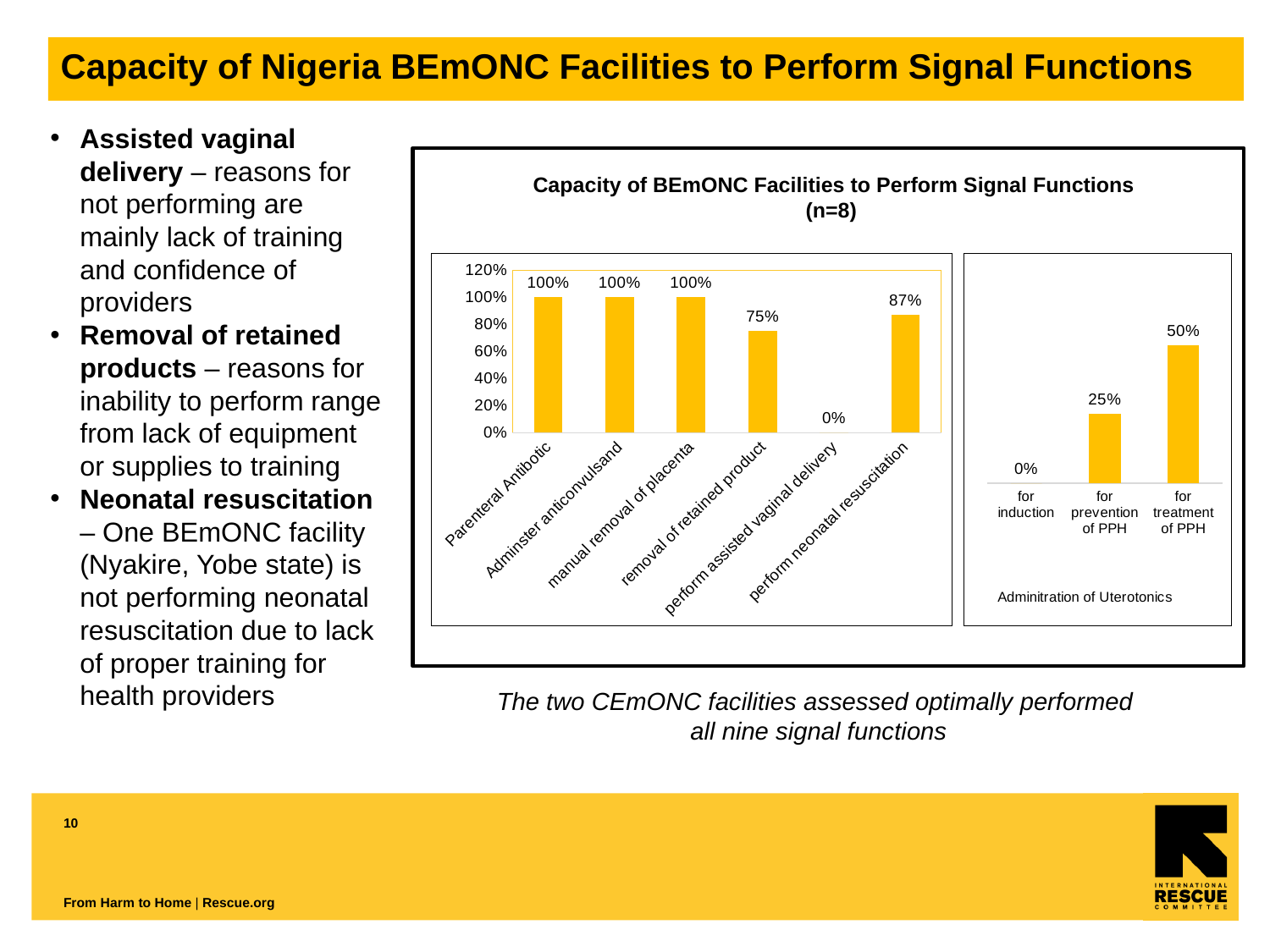
In the left chart (Capacity of BEmONC Facilities to Perform Signal Functions), what is the value for removal of retained product? 75% In the left chart (Capacity of BEmONC Facilities to Perform Signal Functions), what is the value for perform assisted vaginal delivery? 0% In the left chart (Capacity of BEmONC Facilities to Perform Signal Functions), what is the value for perform neonatal resuscitation? 87% In the left chart (Capacity of BEmONC Facilities to Perform Signal Functions), which category has the lowest value? perform assisted vaginal delivery How many categories are shown in the left chart (Capacity of BEmONC Facilities to Perform Signal Functions)? 6 In the right chart (Adminitration of Uterotonics), what is the difference between the values for treatment of PPH and prevention of PPH? 25% What kind of chart is the left chart (Capacity of BEmONC Facilities to Perform Signal Functions)? bar chart In the right chart (Adminitration of Uterotonics), do the values rise or fall from left to right across the categories? rise In the right chart (Adminitration of Uterotonics), which category has the highest value? for treatment of PPH In the left chart (Capacity of BEmONC Facilities to Perform Signal Functions), what is the difference between the values for perform neonatal resuscitation and removal of retained product? 12% In the right chart (Adminitration of Uterotonics), what is the value for prevention of PPH? 25% In the left chart (Capacity of BEmONC Facilities to Perform Signal Functions), which is larger: the value for removal of retained product or the value for perform neonatal resuscitation? perform neonatal resuscitation